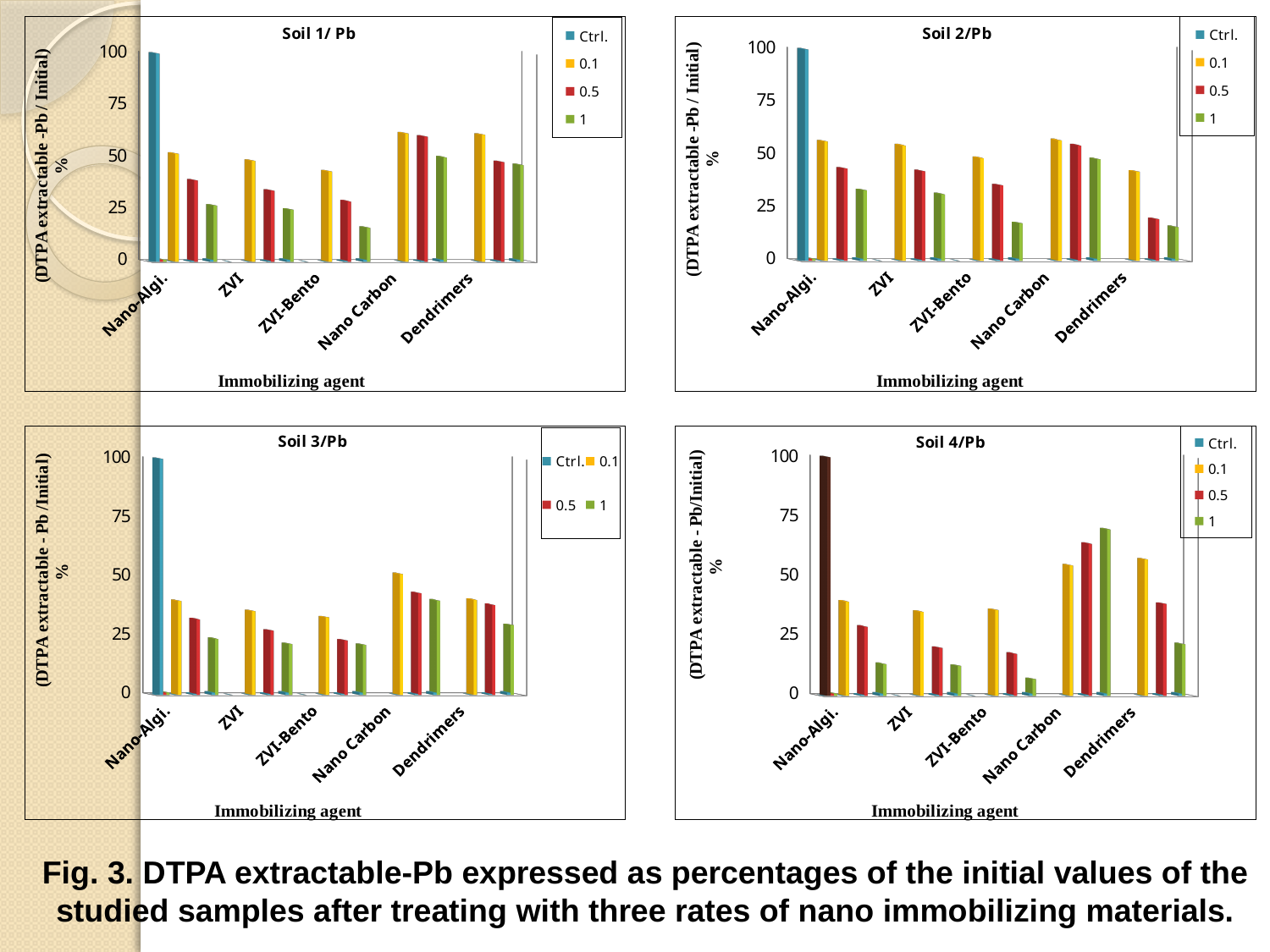
In the Soil 1/ Pb chart, what is the Ctrl. value for Nano-Algi.? 100 In the Soil 2/Pb chart, which is larger for rate 0.1: Nano-Algi. or Dendrimers? Nano-Algi. In the Soil 1/ Pb chart, how many immobilizing agents are shown on the x axis? 5 In the Soil 1/ Pb chart, is the 0.1 value for Nano Carbon greater or less than 50? greater In the Soil 1/ Pb chart, is the value for ZVI-Bento at rate 1 greater or less than 25? less In the Soil 4/Pb chart, is the value for Nano Carbon at rate 1 greater or less than 50? greater What type of chart is the Soil 1/ Pb chart? bar chart In the Soil 4/Pb chart, which immobilizing agent has the highest value for rate 1? Nano Carbon How many series does the legend of the Soil 2/Pb chart list? 4 What is the x-axis title of the Soil 3/Pb chart? Immobilizing agent In the Soil 1/ Pb chart, which immobilizing agent has the lowest value for rate 1? ZVI-Bento